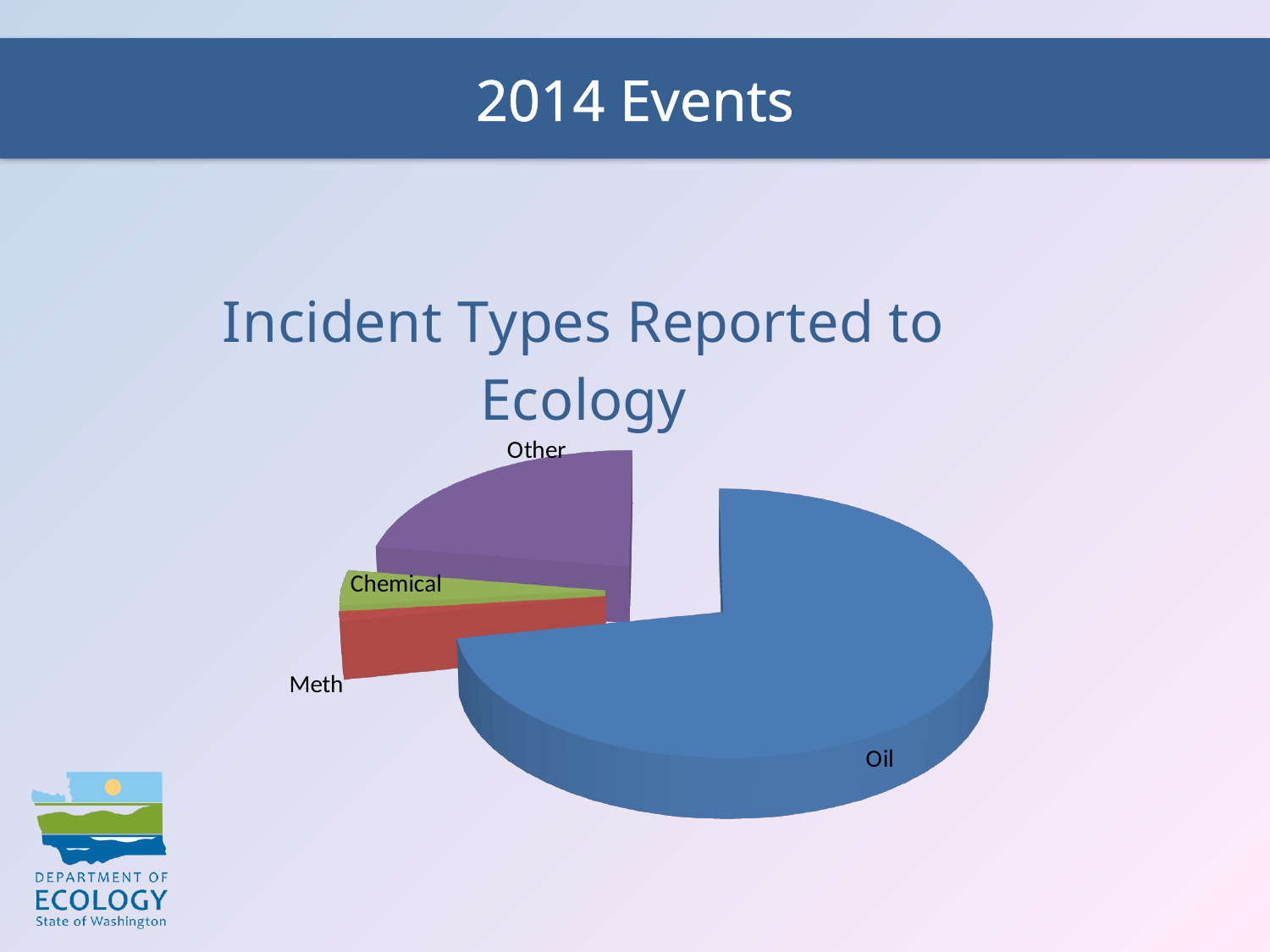
How many slices does the pie chart have? 4 Which slice is larger, Oil or Other? Oil Which incident type has the smallest slice of the pie? Meth What colour is the Oil slice of the pie chart? blue Which slice is larger, Other or Meth? Other Which slice is larger, Chemical or Other? Other What kind of chart is shown on the slide? pie chart What is the title of the pie chart? Incident Types Reported to Ecology Which incident type has the largest slice of the pie? Oil